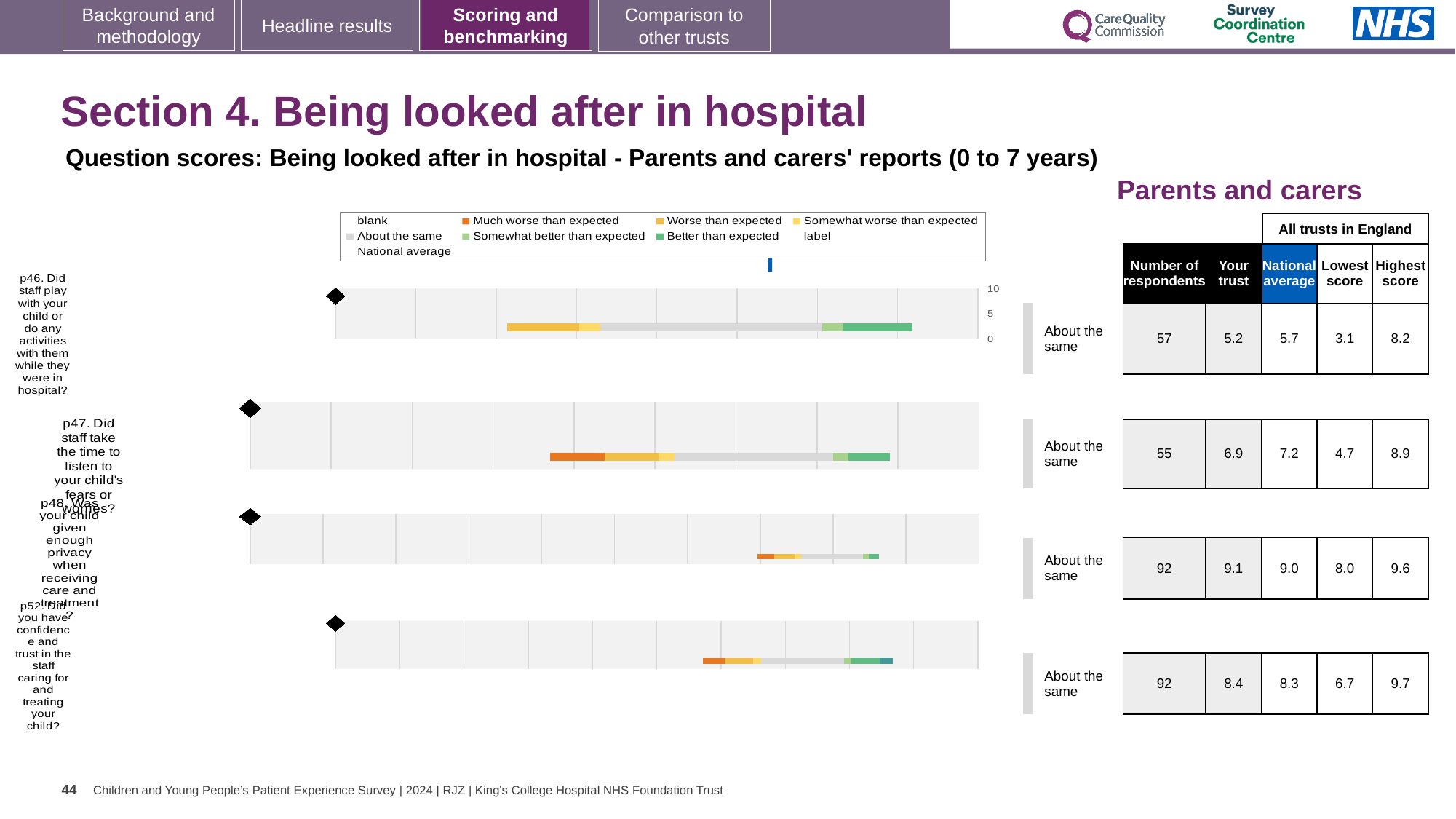
What is the highest score among all trusts in England for p52 (Did you have confidence and trust in the staff caring for and treating your child?)? 9.7 For p47, what is the difference between the highest score and the lowest score among all trusts in England? 4.2 What is the national average score for p47 (Did staff take the time to listen to your child's fears or worries?)? 7.2 Which question has the highest 'Your trust' score? p48 What is the 'Your trust' score for p46 (Did staff play with your child or do any activities with them while they were in hospital?)? 5.2 What benchmark category is shown for p46? About the same For p52, which is larger: the 'Your trust' score or the national average? Your trust How many questions are charted on this slide? 4 For p46, how much higher is the national average than the 'Your trust' score? 0.5 What is the lowest score among all trusts in England for p48? 8.0 How many respondents answered p48 (Was your child given enough privacy when receiving care and treatment?)? 92 Which question has the lowest 'Your trust' score? p46